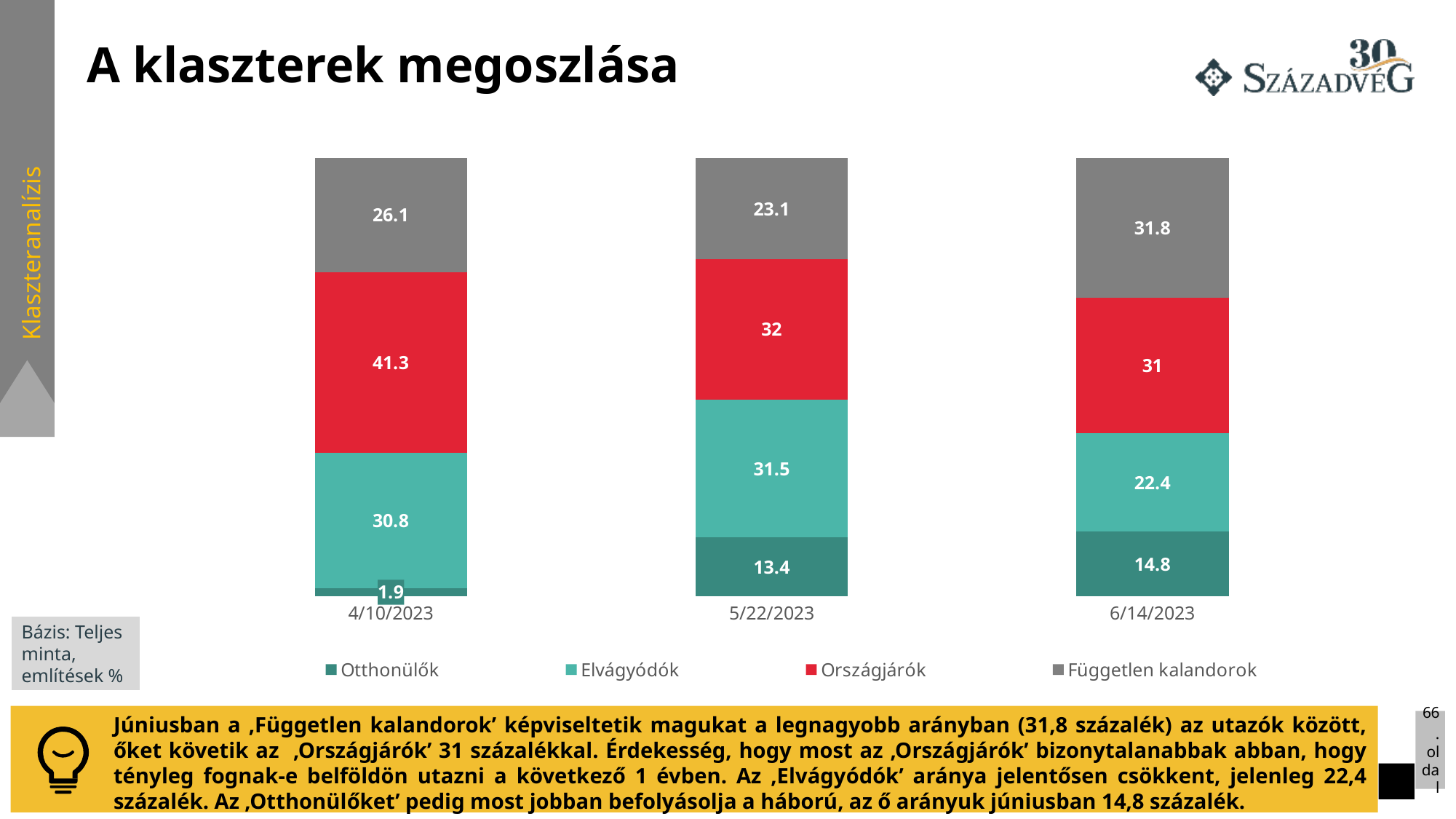
How many dates are shown on the x axis? 3 On which date is the value for Otthonülők lowest? 4/10/2023 Which is larger on 6/14/2023: Országjárók or Független kalandorok? Független kalandorok What is the value for Elvágyódók on 6/14/2023? 22.4 How many series does the legend list? 4 On which date is the value for Országjárók highest? 4/10/2023 What kind of chart is shown on the slide? Stacked bar chart What is the value for Független kalandorok on 6/14/2023? 31.8 What is the value for Országjárók on 4/10/2023? 41.3 What is the value for Otthonülők on 5/22/2023? 13.4 What is the difference between the Elvágyódók values on 5/22/2023 and 6/14/2023? 9.1 Does the value for Otthonülők rise or fall from 4/10/2023 to 6/14/2023? Rise